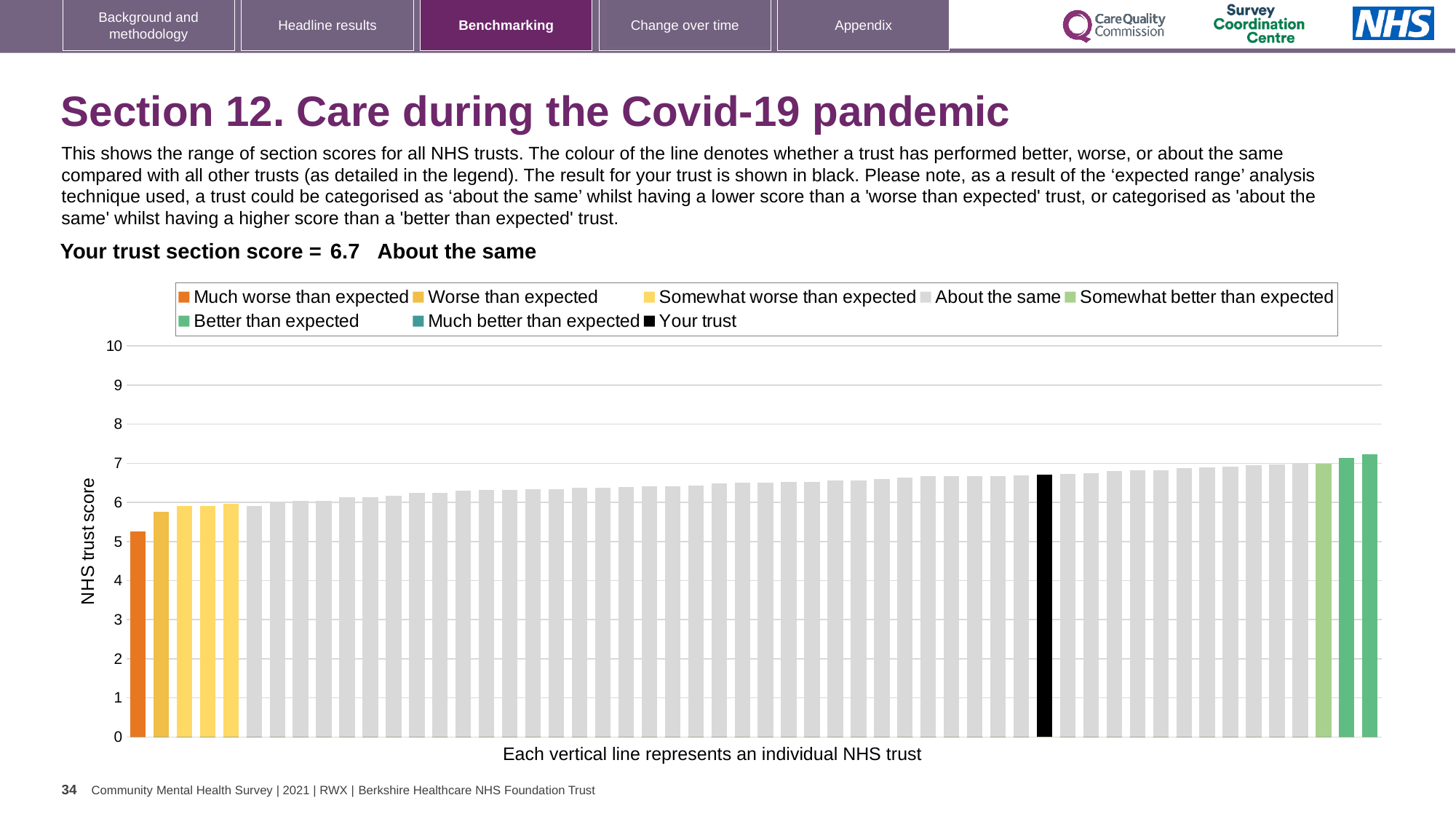
Do the bar values rise or fall from left to right along the x axis? rise What colour is the bar representing your trust? black Which category is your trust placed in for this section? About the same Is the value of the orange bar (much worse than expected) greater or less than 6? less Is the value of the tallest bar greater or less than 7? greater How many bars are coloured orange (much worse than expected)? 1 What is the label of the vertical axis? NHS trust score What kind of chart is shown on the slide? bar chart Is the value of the black bar (your trust) greater or less than 6? greater Which is larger, the bar for your trust or the orange bar? your trust How many entries does the chart legend list? 8 What is the section score for your trust shown on the slide? 6.7